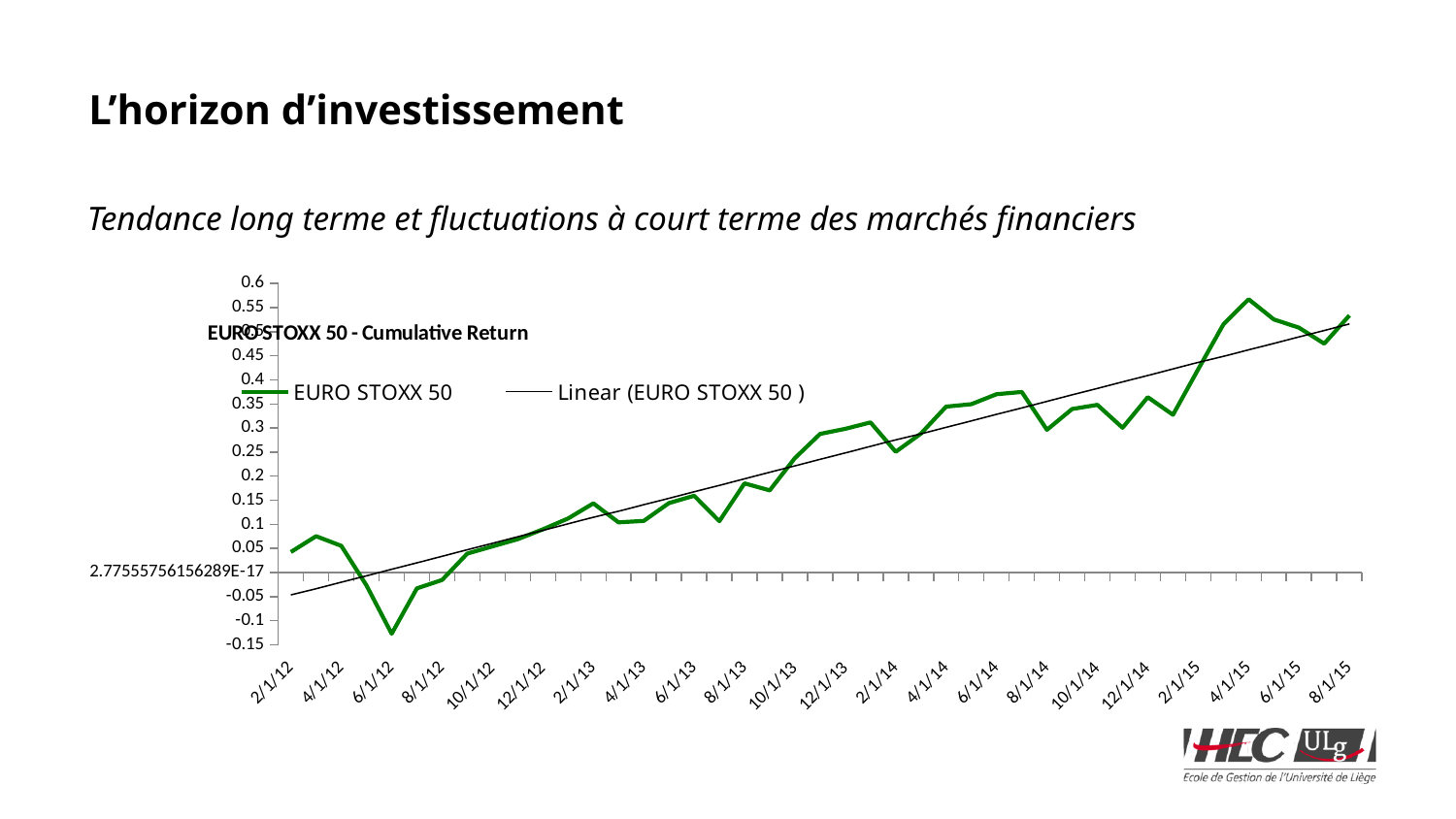
Is the EURO STOXX 50 value at 2/1/14 greater or less than 0.3? less Around which x-axis date does the EURO STOXX 50 line reach its highest point? 4/1/15 Is the EURO STOXX 50 value at 6/1/12 greater or less than 0? less What is the title of the chart? EURO STOXX 50 - Cumulative Return Overall, does the EURO STOXX 50 cumulative return rise or fall from 2/1/12 to 8/1/15? rise Is the EURO STOXX 50 value at 2/1/12 greater or less than 0.1? less Around which x-axis date does the EURO STOXX 50 line reach its lowest point? 6/1/12 How many series does the legend list? 2 Which is larger, the EURO STOXX 50 value at 6/1/12 or at 8/1/15? 8/1/15 What kind of chart is shown on the slide? line chart What are the two entries in the chart legend? EURO STOXX 50 and Linear (EURO STOXX 50 )